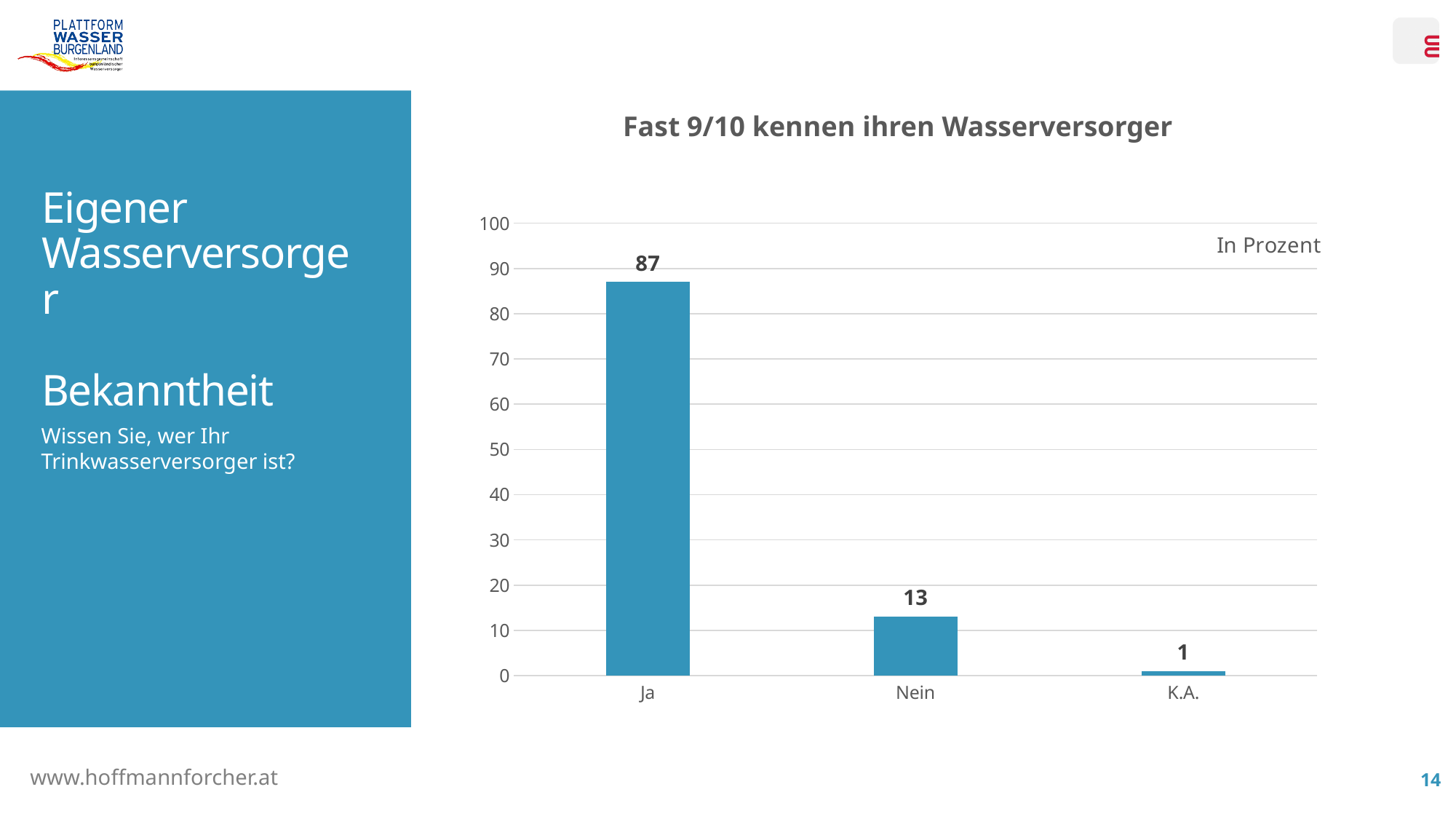
What is the difference between the values for "Ja" and "Nein"? 74 How many categories are shown on the x axis? 3 What is the difference between the values for "Nein" and "K.A."? 12 What kind of chart is shown on the slide? bar chart Which is larger, the value for "Nein" or the value for "K.A."? Nein Is the value for "Ja" greater or less than 80? greater What is the value for "K.A."? 1 What is the value for "Ja"? 87 What is the value for "Nein"? 13 What is the title of the chart? Fast 9/10 kennen ihren Wasserversorger Which category has the highest value? Ja Which category has the lowest value? K.A.